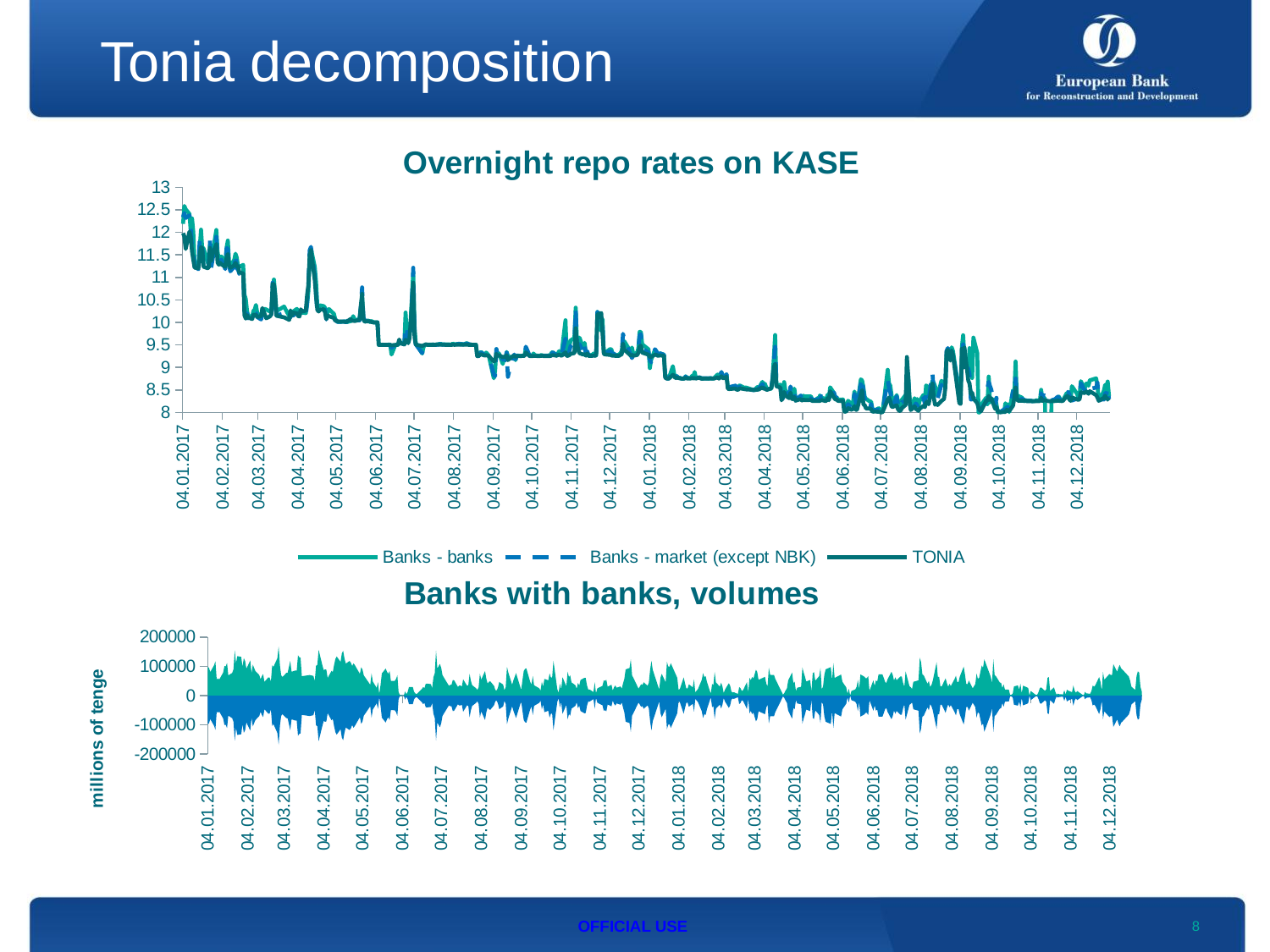
In the 'Overnight repo rates on KASE' chart, do the rates generally rise or fall from 04.01.2017 to 04.12.2018? fall How many date labels are shown on the x axis of the 'Banks with banks, volumes' chart? 24 In the 'Overnight repo rates on KASE' chart, is the TONIA value at 04.08.2017 greater or less than 10? less What is the title of the top chart on the slide? Overnight repo rates on KASE What kind of chart is the 'Banks with banks, volumes' chart? area chart In the 'Overnight repo rates on KASE' chart, is the TONIA value at 04.03.2017 greater or less than 9? greater What are the legend entries of the 'Overnight repo rates on KASE' chart? Banks - banks, Banks - market (except NBK), TONIA In the 'Overnight repo rates on KASE' chart, is the TONIA value at 04.01.2017 greater or less than 11? greater What kind of chart is the 'Overnight repo rates on KASE' chart? line chart How many series does the legend of the 'Overnight repo rates on KASE' chart list? 3 What is the y-axis label of the 'Banks with banks, volumes' chart? millions of tenge